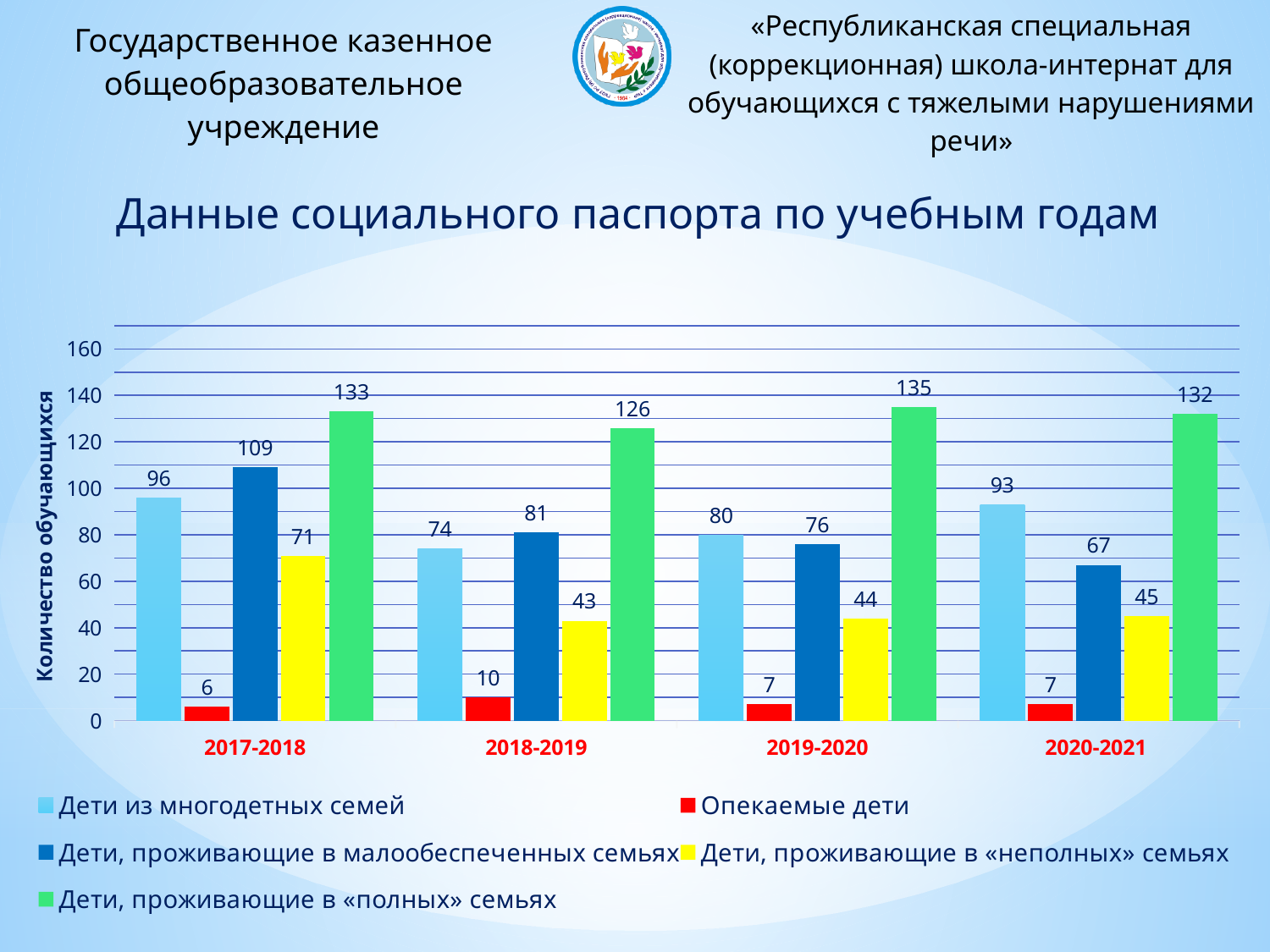
What is the value for «Дети, проживающие в «полных» семьях» in 2019-2020? 135 What kind of chart is shown on the slide? Bar chart What is the value for «Опекаемые дети» in 2018-2019? 10 What is the difference between the values for «Дети, проживающие в «полных» семьях» in 2017-2018 and 2018-2019? 7 What is the value for «Дети, проживающие в «неполных» семьях» in 2020-2021? 45 In which school year is the value for «Дети из многодетных семей» lowest? 2018-2019 In which school year is the value for «Дети, проживающие в малообеспеченных семьях» highest? 2017-2018 What is the title of the chart? Данные социального паспорта по учебным годам How many school years are shown on the x axis? 4 What is the value for «Дети из многодетных семей» in 2017-2018? 96 How many series does the legend list? 5 Which is larger in 2019-2020: «Дети из многодетных семей» or «Дети, проживающие в малообеспеченных семьях»? Дети из многодетных семей